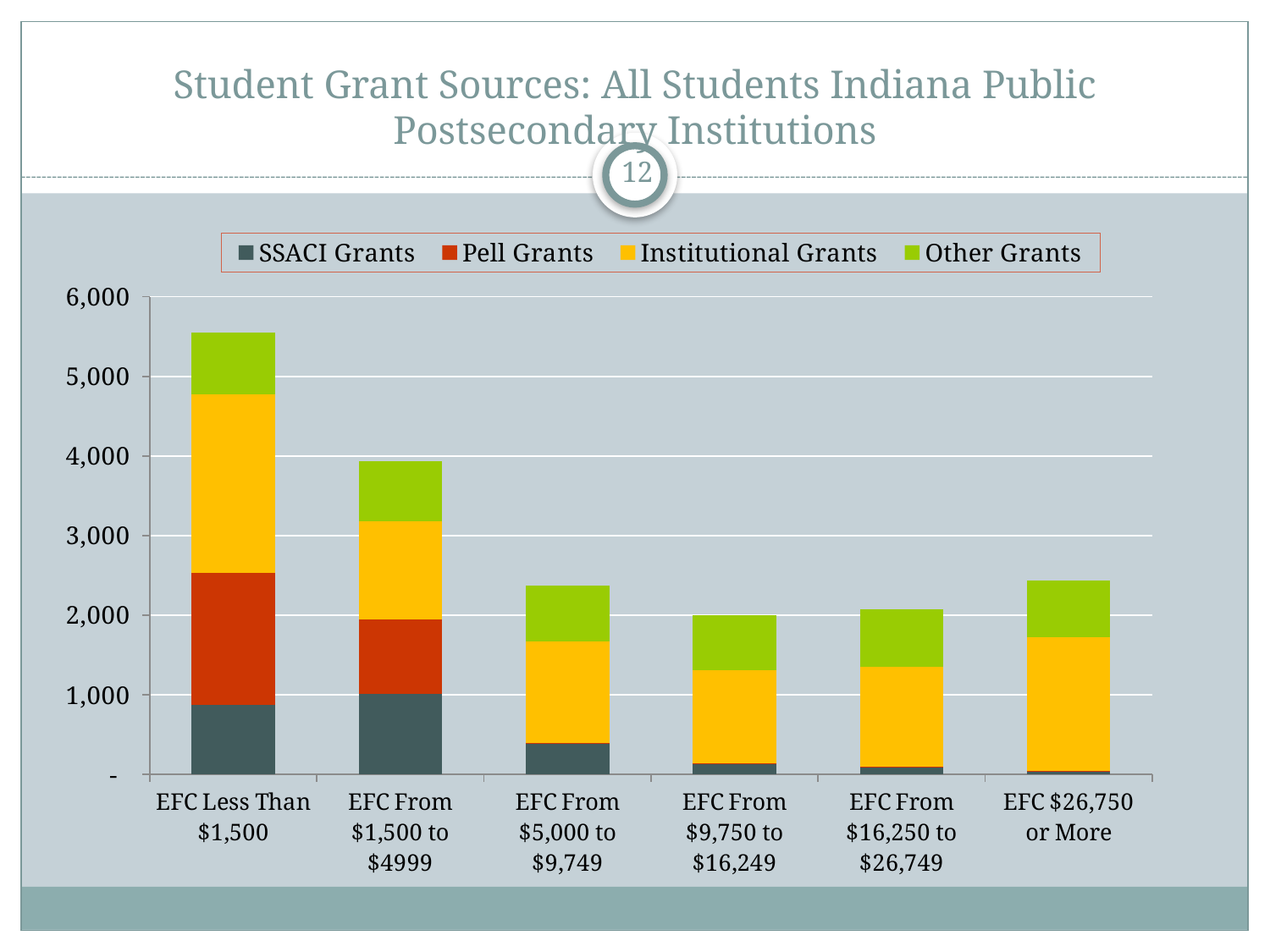
Do the total bar heights rise or fall across the first four EFC categories from left to right? fall How many series does the legend list? 4 Which is larger, the Pell Grants segment for EFC Less Than $1,500 or for EFC From $1,500 to $4999? EFC Less Than $1,500 Is the total for EFC From $9,750 to $16,249 greater or less than 3,000? less How many EFC categories are shown on the x axis? 6 Is the total for EFC $26,750 or More greater or less than 2,000? greater What kind of chart is shown on the slide? Stacked bar chart Is the total for EFC Less Than $1,500 greater or less than 5,000? greater Which is larger, the total for EFC From $5,000 to $9,749 or the total for EFC From $1,500 to $4999? EFC From $1,500 to $4999 Which EFC category has the highest total grant amount? EFC Less Than $1,500 Which series is shown in yellow in the legend? Institutional Grants